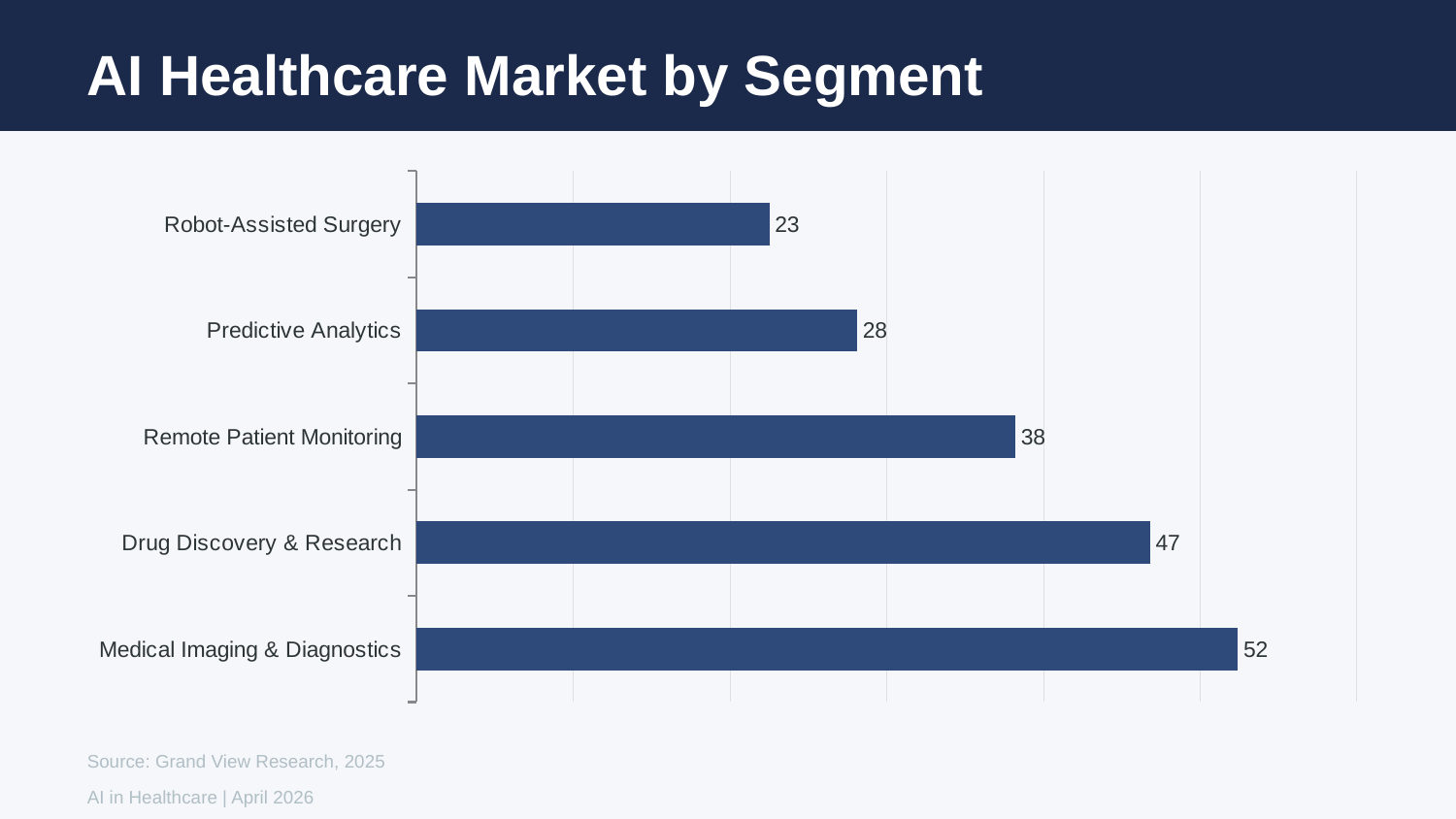
Which segment has the lowest value? Robot-Assisted Surgery What is the value for Robot-Assisted Surgery? 23 What kind of chart is shown on the slide? Bar chart How many segments are shown in the chart? 5 What is the value for Remote Patient Monitoring? 38 What is the difference between the values for Medical Imaging & Diagnostics and Drug Discovery & Research? 5 What is the value for Medical Imaging & Diagnostics? 52 Which segment has the highest value? Medical Imaging & Diagnostics Which is larger, the value for Drug Discovery & Research or the value for Remote Patient Monitoring? Drug Discovery & Research What is the difference between the values for Remote Patient Monitoring and Predictive Analytics? 10 What is the title of the chart? AI Healthcare Market by Segment What is the value for Predictive Analytics? 28